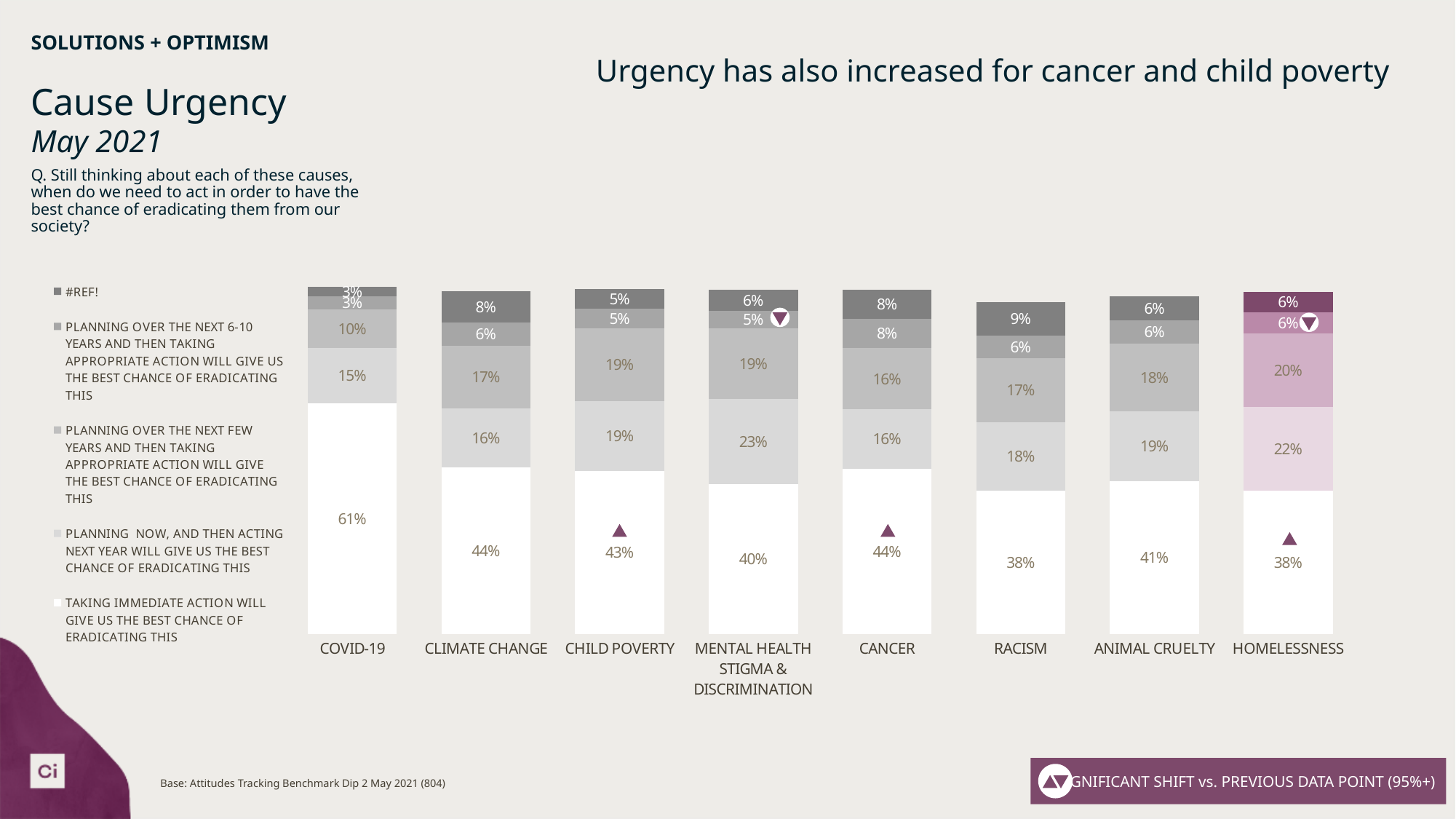
What is the 'planning now, and then acting next year' value for Mental Health Stigma & Discrimination? 23% What percentage of respondents said taking immediate action gives the best chance of eradicating COVID-19? 61% What is the difference in percentage points between the 'taking immediate action' values for COVID-19 and Climate Change? 17 percentage points What is the 'taking immediate action' value for Homelessness? 38% Which cause has the highest share for 'taking immediate action will give us the best chance of eradicating this'? COVID-19 Which has a larger 'taking immediate action' value: Cancer or Mental Health Stigma & Discrimination? Cancer How many causes (categories) are shown along the x axis of the chart? 8 Which cause's bar is highlighted in purple rather than grey? Homelessness How many entries does the chart's legend list? 5 What kind of chart is shown on the slide? Stacked bar chart What is the total of the labelled segments in the Cancer bar? 92% What is the 'taking immediate action' value for Racism? 38%